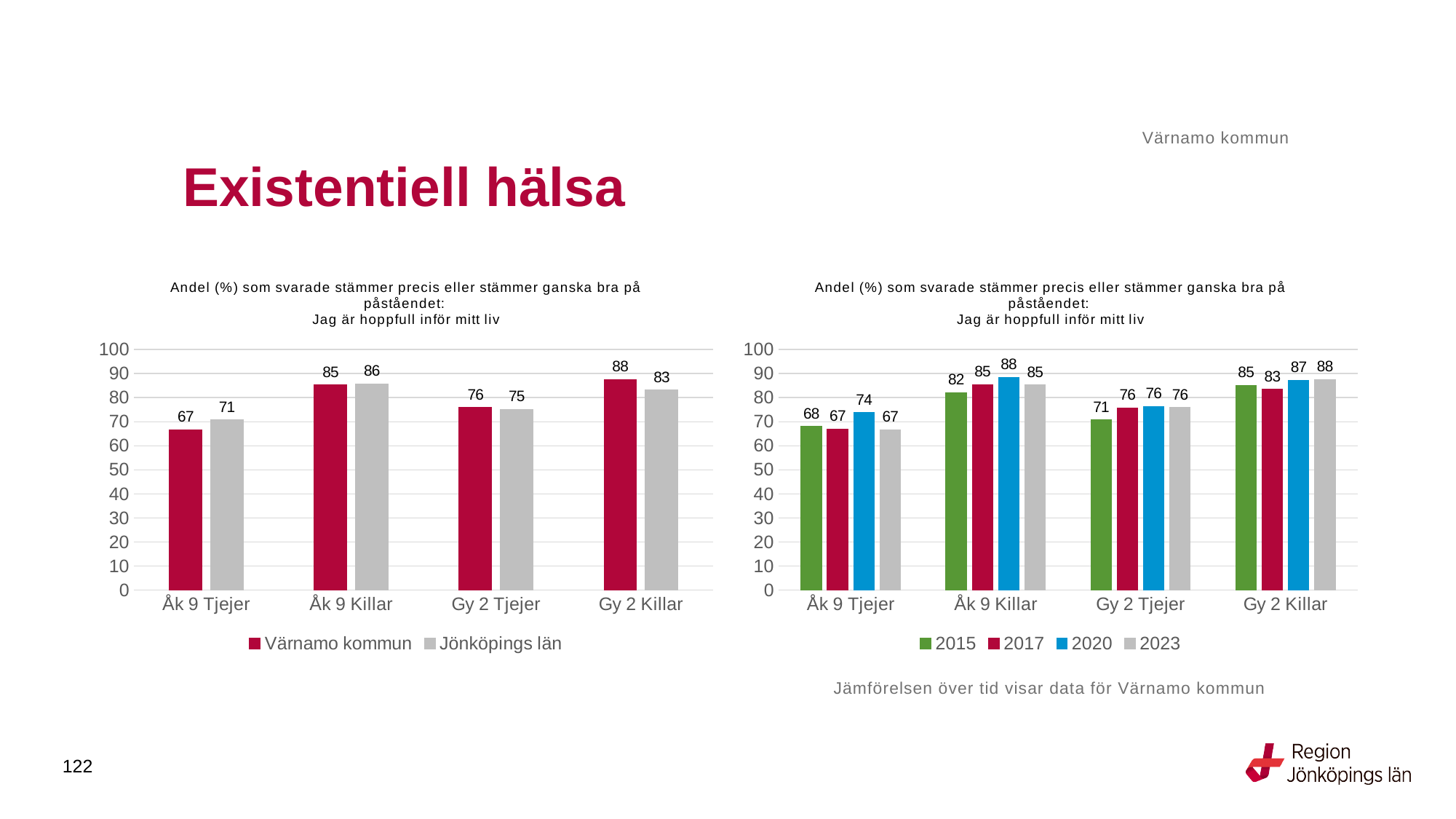
How many series does the legend of the right chart list? 4 In the left chart, what is the difference between Jönköpings län and Värnamo kommun for Åk 9 Tjejer? 4 In the left chart, what is the value for Värnamo kommun for Åk 9 Tjejer? 67 In the right chart, what is the value for 2020 for Åk 9 Tjejer? 74 In the left chart, what is the value for Jönköpings län for Gy 2 Killar? 83 What type of chart is the right chart? Bar chart In the right chart, what is the value for 2015 for Gy 2 Tjejer? 71 In the left chart, which category has the highest value for Värnamo kommun? Gy 2 Killar In the left chart, which is larger for Gy 2 Tjejer: Värnamo kommun or Jönköpings län? Värnamo kommun In the right chart, what is the difference between 2020 and 2015 for Åk 9 Tjejer? 6 How many series does the legend of the left chart list? 2 In the right chart, which year has the lowest value for Åk 9 Killar? 2015